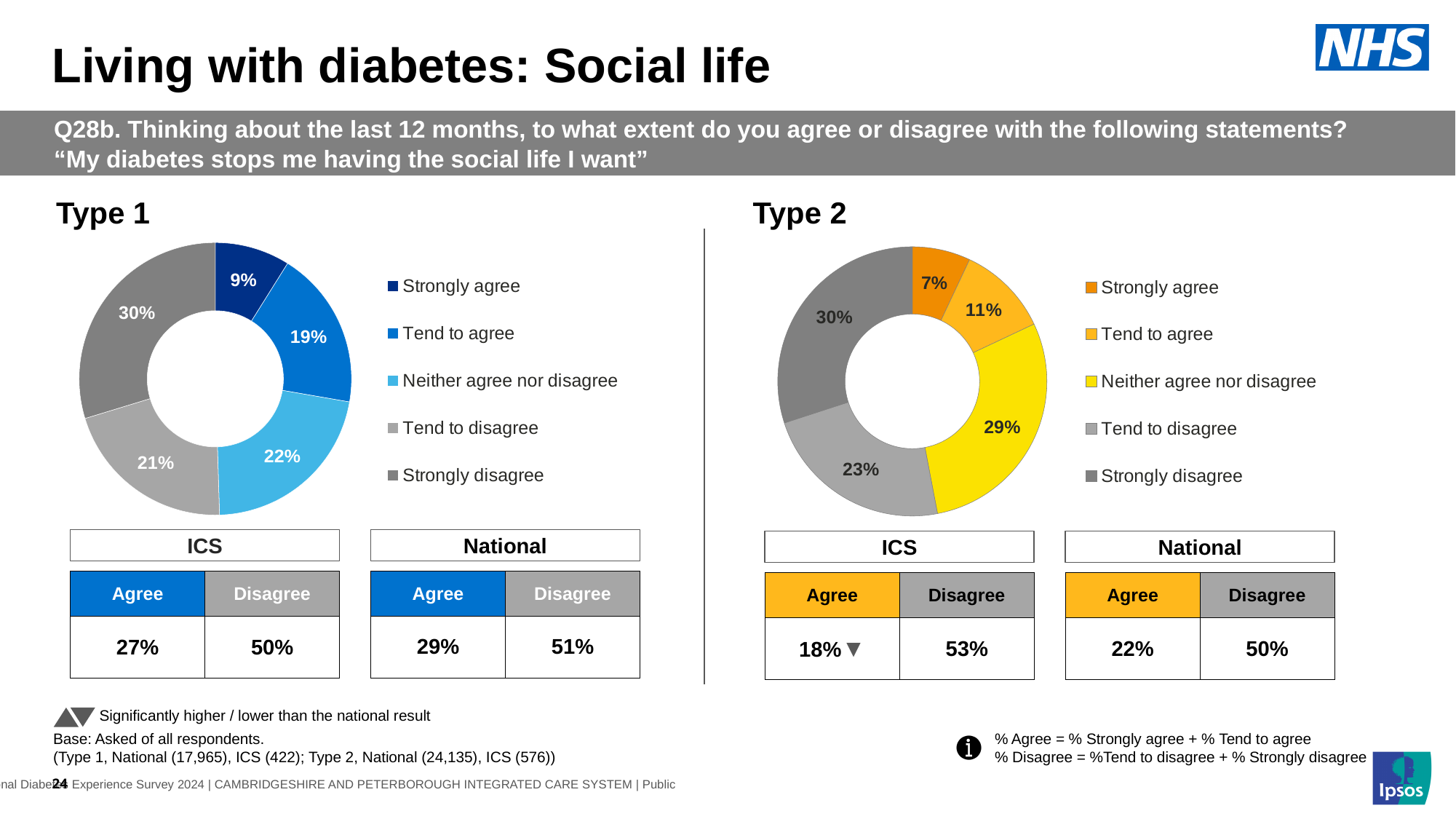
In the Type 1 chart, what colour is the 'Neither agree nor disagree' segment? Light blue In the Type 1 chart, what percentage of respondents said 'Strongly agree'? 9% In the Type 1 chart, which response category has the largest share? Strongly disagree In the Type 1 chart, what is the difference in percentage points between 'Strongly disagree' and 'Strongly agree'? 21 How many response categories does the legend of the Type 1 chart list? 5 In the Type 2 chart, which is larger: 'Tend to disagree' or 'Tend to agree'? Tend to disagree What kind of chart is used to show the Type 2 results? Donut (pie) chart In the Type 2 chart, what is the combined share of 'Strongly agree' and 'Tend to agree'? 18% In the Type 2 chart, what percentage of respondents said 'Neither agree nor disagree'? 29% In the Type 2 chart, what percentage of respondents said 'Tend to agree'? 11% In the Type 1 chart, what percentage of respondents said 'Tend to disagree'? 21% In the Type 2 chart, which response category has the smallest share? Strongly agree